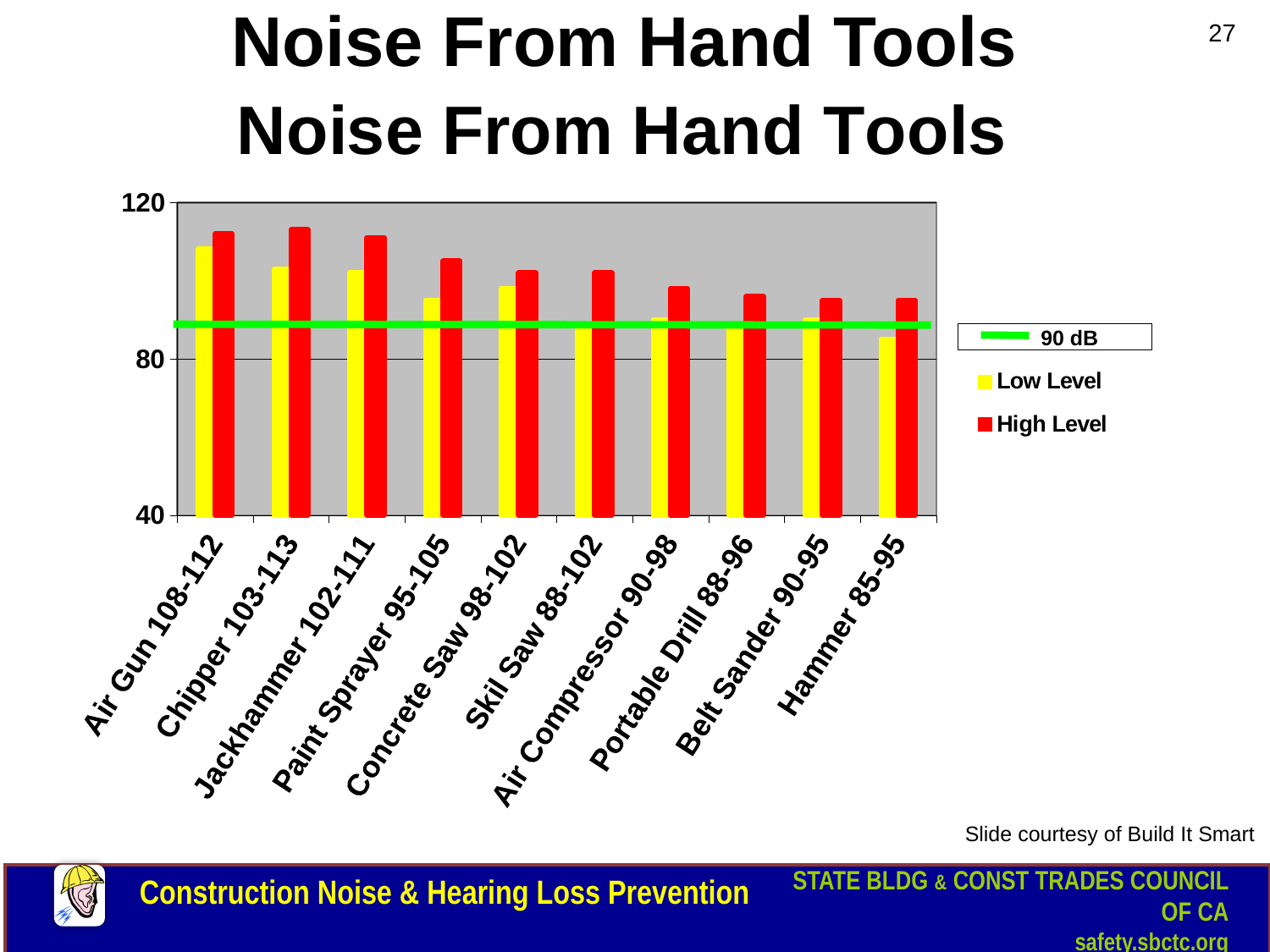
What noise level range is given for the Chipper in the chart? 103-113 Which tool has the lowest Low Level value in the chart? Hammer Is the Low Level value for the Hammer greater or less than 90? less Which has a higher Low Level value, the Air Gun or the Chipper? Air Gun Do the High Level values generally rise or fall moving from left to right across the x axis? Fall What is the difference between the High Level and Low Level values for the Air Gun? 4 What value does the green horizontal line in the chart represent, according to the legend? 90 dB What noise level range is given for the Hammer in the chart? 85-95 How many entries does the chart's legend list? 3 What type of chart is shown on the slide? Bar chart How many tools (categories) are shown on the x axis of the chart? 10 Which tool has the highest High Level value in the chart? Chipper